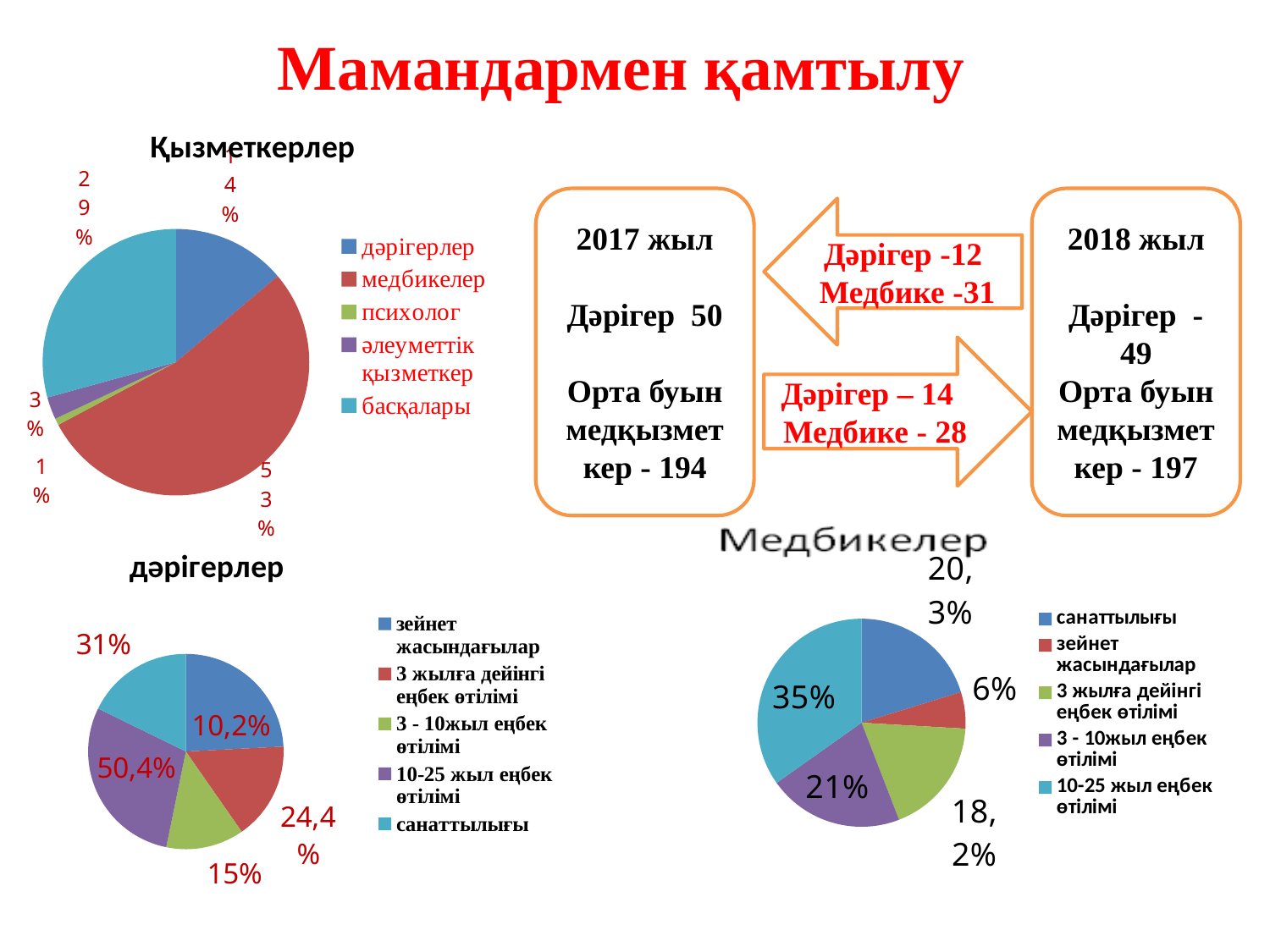
In the Медбикелер chart, what is the difference between the 10-25 жыл еңбек өтілімі share and the зейнет жасындағылар share? 29% In the Медбикелер chart, what percentage is shown for 10-25 жыл еңбек өтілімі? 35% How many entries does the legend of the дәрігерлер chart list? 5 In the Қызметкерлер chart, what percentage is shown for медбикелер? 53% In the Қызметкерлер chart, which is larger: басқалары or дәрігерлер? басқалары In the Қызметкерлер chart, what percentage is shown for дәрігерлер? 14% In the Қызметкерлер chart, which category has the largest share? медбикелер In the Қызметкерлер chart, what is the difference between the медбикелер share and the дәрігерлер share? 39% In the дәрігерлер chart, what percentage is shown for 10-25 жыл еңбек өтілімі? 50,4% In the Медбикелер chart, which category has the smallest share? зейнет жасындағылар What kind of chart is the Медбикелер chart? pie chart In the Қызметкерлер chart, which category has the smallest share? психолог